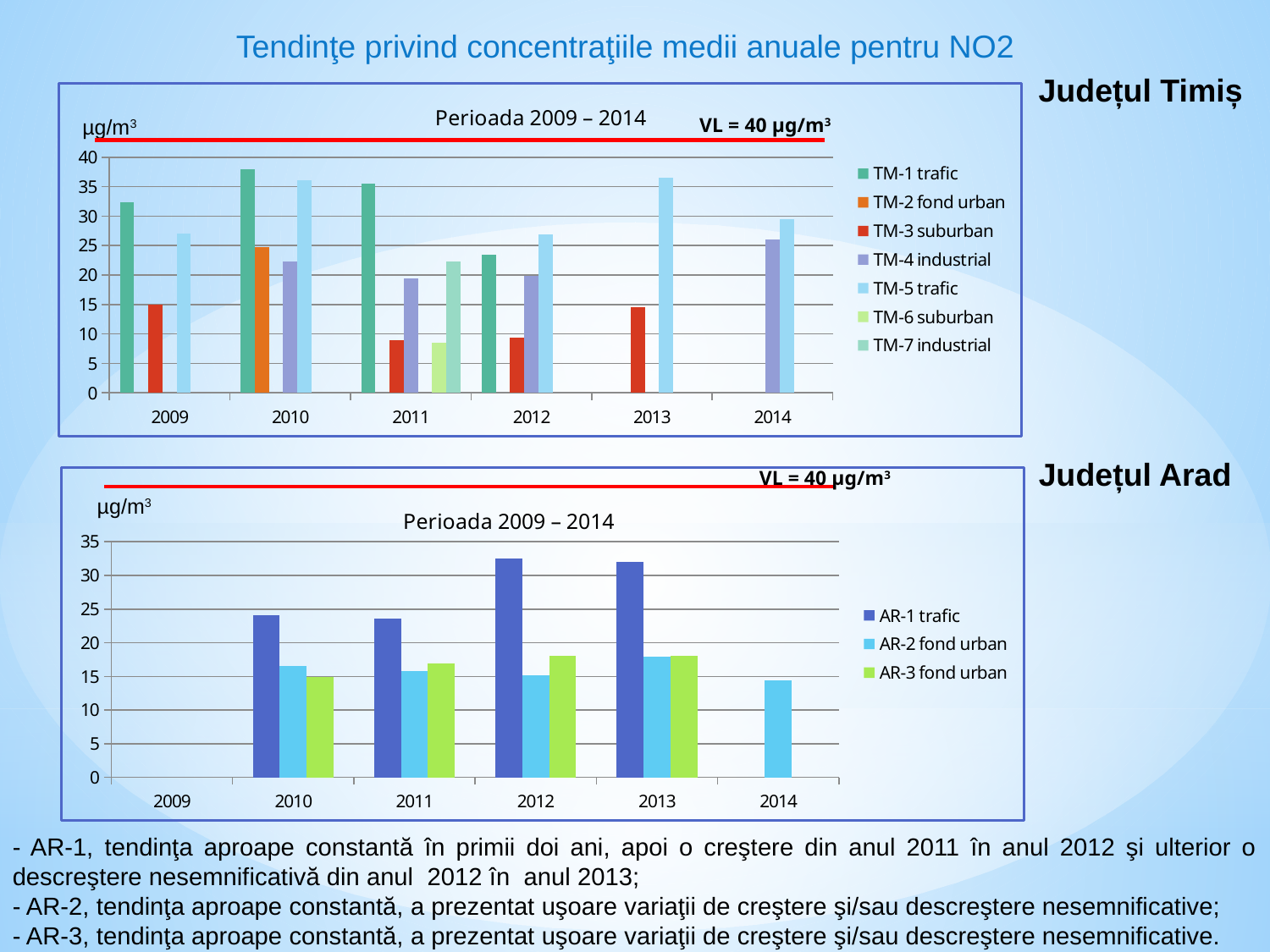
How many series does the legend of the Județul Arad chart list? 3 What kind of chart is the Județul Timiș chart? bar chart How many series does the legend of the Județul Timiș chart list? 7 In the Județul Arad chart, is the value for AR-1 trafic in 2012 greater or less than 30? greater In the Județul Timiș chart, is the value for TM-1 trafic in 2010 greater or less than 35? greater In the Județul Timiș chart, which is larger in 2009: TM-1 trafic or TM-3 suburban? TM-1 trafic In the Județul Timiș chart, is the value for TM-6 suburban in 2011 greater or less than 10? less How many years are shown on the x axis of the Județul Arad chart? 6 In the Județul Arad chart, which series has the highest value in 2010? AR-1 trafic What limit value (VL) is marked by the red line on both charts? VL = 40 µg/m³